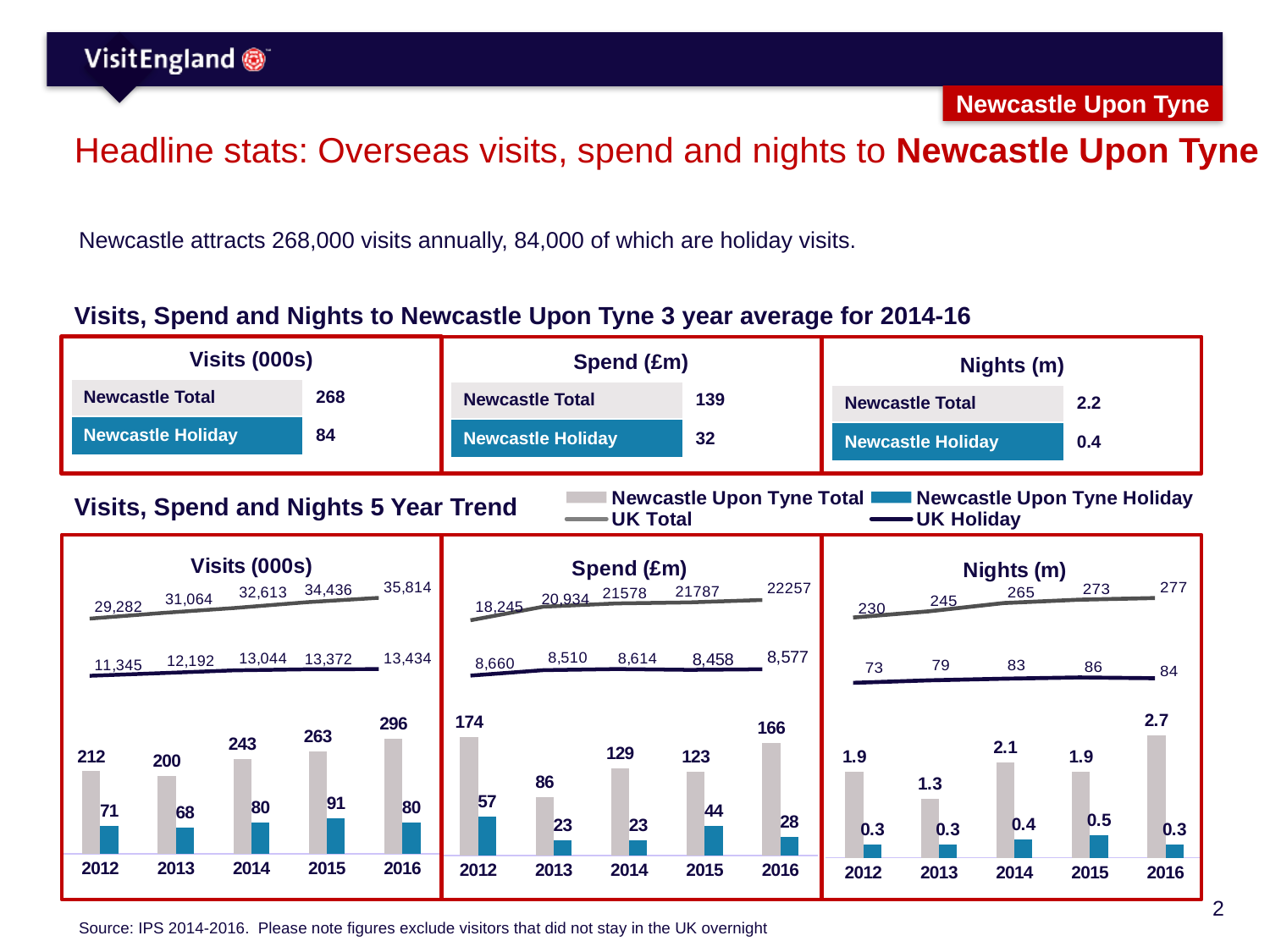
How many years are shown on the x axis of the Visits (000s) trend chart? 5 In the Spend (£m) trend chart, what is the UK Holiday value for 2012? 8,660 In the Spend (£m) trend chart, which year has the highest Newcastle Upon Tyne Total value? 2012 In the Visits (000s) trend chart, does the UK Total line rise or fall from 2012 to 2016? Rise What kind of chart is used for the Newcastle Upon Tyne Total and Holiday values in the Nights (m) trend chart? Bar chart In the Spend (£m) trend chart, is the Newcastle Upon Tyne Total value larger in 2014 or 2015? 2014 In the Nights (m) trend chart, what is the difference between the Newcastle Upon Tyne Total values for 2016 and 2013? 1.4 In the Nights (m) trend chart, what is the UK Total value for 2014? 265 In the Visits (000s) trend chart, what is the Newcastle Upon Tyne Total value for 2016? 296 How many series does the legend for the 5 Year Trend charts list? 4 In the Visits (000s) trend chart, which year has the lowest Newcastle Upon Tyne Holiday value? 2013 In the Spend (£m) trend chart, what is the Newcastle Upon Tyne Holiday value for 2015? 44